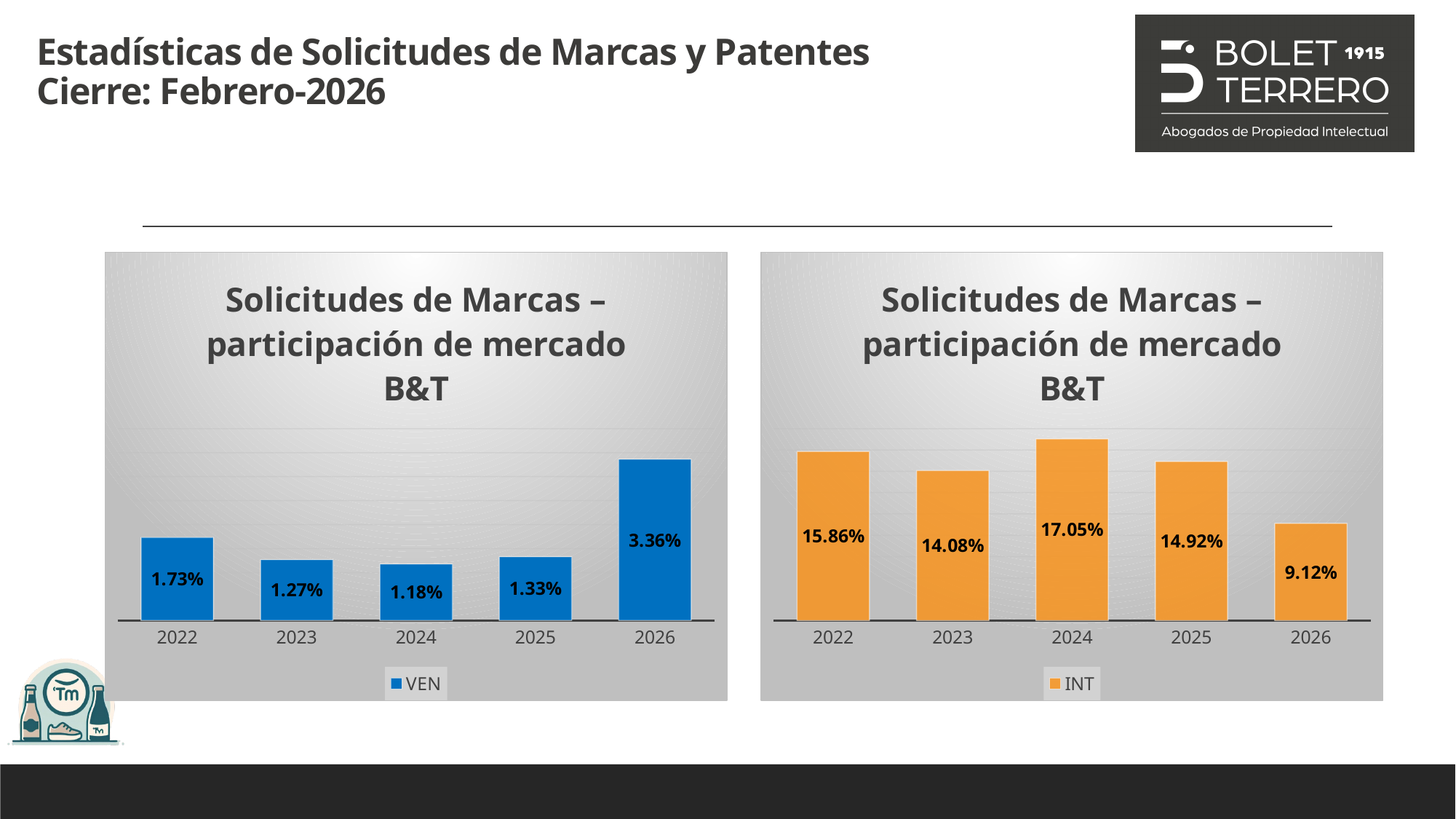
In the right chart (INT), what is the difference between the 2022 value and the 2023 value? 1.78% In the left chart (VEN), what is the difference between the 2026 value and the 2025 value? 2.03% In the right chart (INT), which year has the lowest value? 2026 How many series does the legend of the left chart list? 1 What is the legend entry of the right chart? INT In the right chart (INT), which year has the highest value? 2024 How many years are shown on the x axis of the left chart (VEN)? 5 What kind of chart is the right chart (INT)? bar chart In the left chart (VEN), what is the value for 2026? 3.36% In the left chart (VEN), which year has the lowest value? 2024 In the right chart (INT), which is larger, the value for 2023 or the value for 2025? 2025 In the right chart (INT), what is the value for 2024? 17.05%